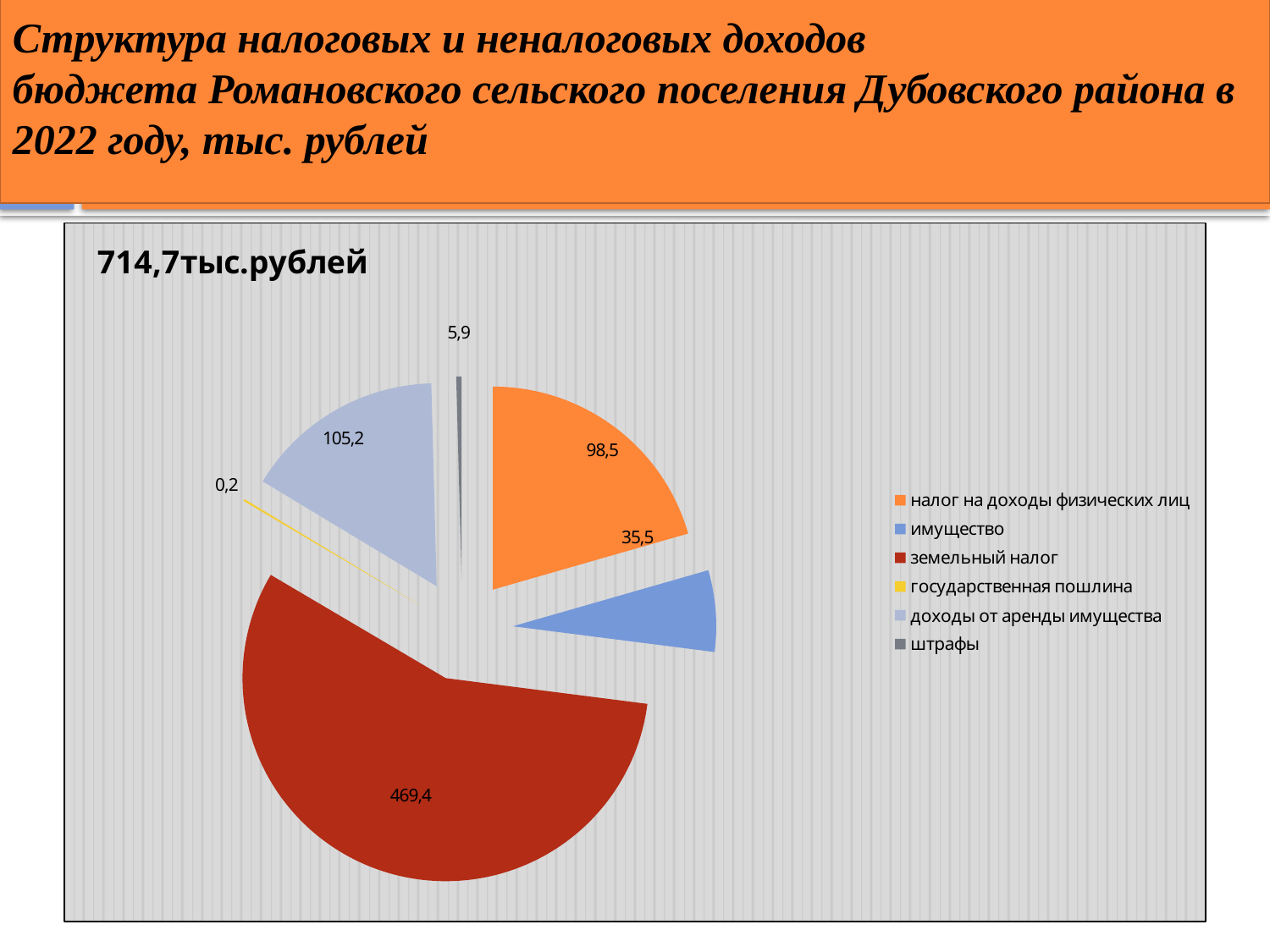
What is the value for доходы от аренды имущества? 105,2 What is the difference between the values for земельный налог and доходы от аренды имущества? 364,2 What is the value for штрафы? 5,9 What total amount is shown as the chart title? 714,7тыс.рублей What is the value for земельный налог? 469,4 Which category has the largest slice of the pie? земельный налог What kind of chart is shown on the slide? pie chart Which is larger, the value for доходы от аренды имущества or the value for налог на доходы физических лиц? доходы от аренды имущества How many categories does the legend list? 6 What is the value for имущество? 35,5 What is the value for налог на доходы физических лиц? 98,5 Which category has the smallest slice of the pie? государственная пошлина